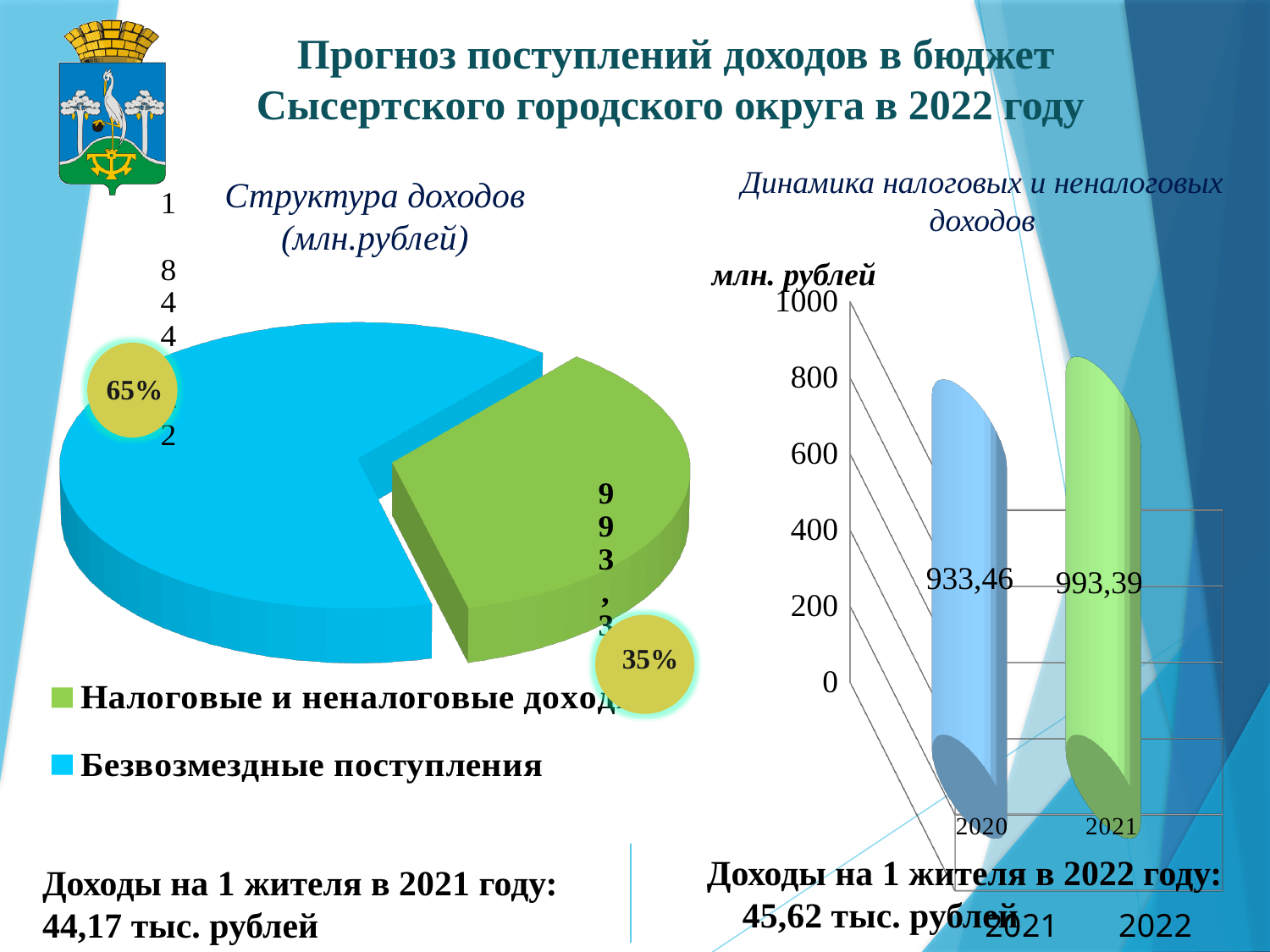
In the chart 'Динамика налоговых и неналоговых доходов', what is the value of the right bar (2021)? 993,39 In the pie chart 'Структура доходов (млн.рублей)', what share does 'Безвозмездные поступления' have? 65% In the pie chart 'Структура доходов (млн.рублей)', what share does 'Налоговые и неналоговые доходы' have? 35% In the chart 'Динамика налоговых и неналоговых доходов', what is the value of the left bar (2020)? 933,46 In the chart 'Динамика налоговых и неналоговых доходов', what is the difference between the right bar (993,39) and the left bar (933,46)? 59,93 How many slices does the pie chart 'Структура доходов (млн.рублей)' have? 2 In the chart 'Динамика налоговых и неналоговых доходов', which bar is higher, the left (2020) or the right (2021)? The right bar (2021) In the chart 'Динамика налоговых и неналоговых доходов', do the values rise or fall from the left bar to the right bar? Rise In the pie chart 'Структура доходов (млн.рублей)', which slice is larger: 'Налоговые и неналоговые доходы' or 'Безвозмездные поступления'? Безвозмездные поступления What kind of chart is 'Структура доходов (млн.рублей)'? Pie chart In the pie chart 'Структура доходов (млн.рублей)', what colour is the 'Безвозмездные поступления' slice? Blue What kind of chart is 'Динамика налоговых и неналоговых доходов'? Bar chart